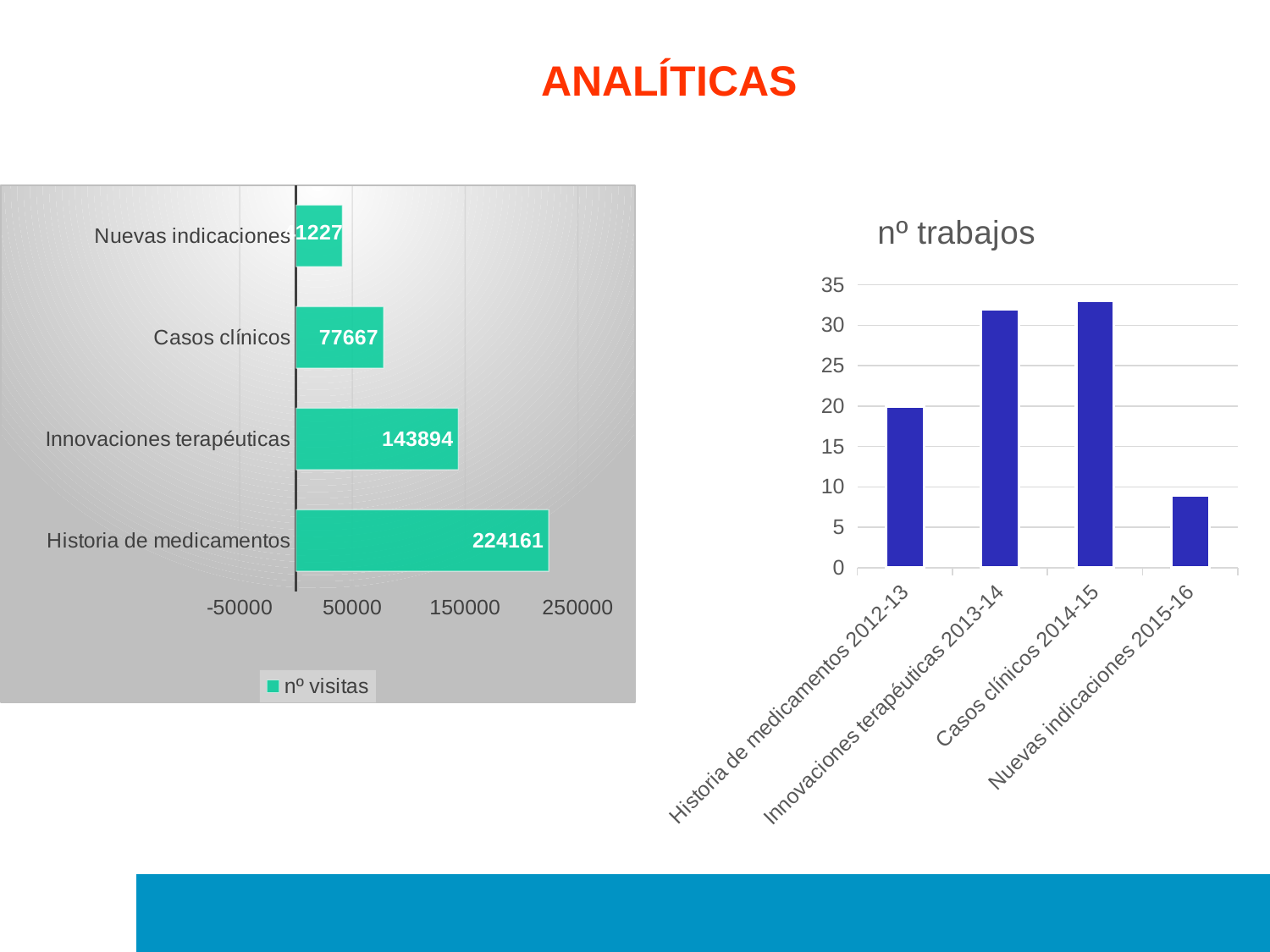
In the left chart, what is the legend entry for the series? nº visitas In the left chart (nº visitas), which category has the highest value? Historia de medicamentos How many categories are shown in the right chart (nº trabajos)? 4 In the left chart (nº visitas), which category has the lowest value? Nuevas indicaciones In the right chart (nº trabajos), which category has the lowest value? Nuevas indicaciones 2015-16 In the left chart (nº visitas), what is the value for Nuevas indicaciones? 41227 In the left chart (nº visitas), what is the difference between Historia de medicamentos and Innovaciones terapéuticas? 80267 In the left chart (nº visitas), what is the value for Casos clínicos? 77667 In the left chart (nº visitas), what is the value for Historia de medicamentos? 224161 In the left chart (nº visitas), which is larger: Casos clínicos or Innovaciones terapéuticas? Innovaciones terapéuticas In the right chart (nº trabajos), is the value for Historia de medicamentos 2012-13 greater or less than 25? less In the right chart (nº trabajos), is the value for Innovaciones terapéuticas 2013-14 greater or less than 25? greater